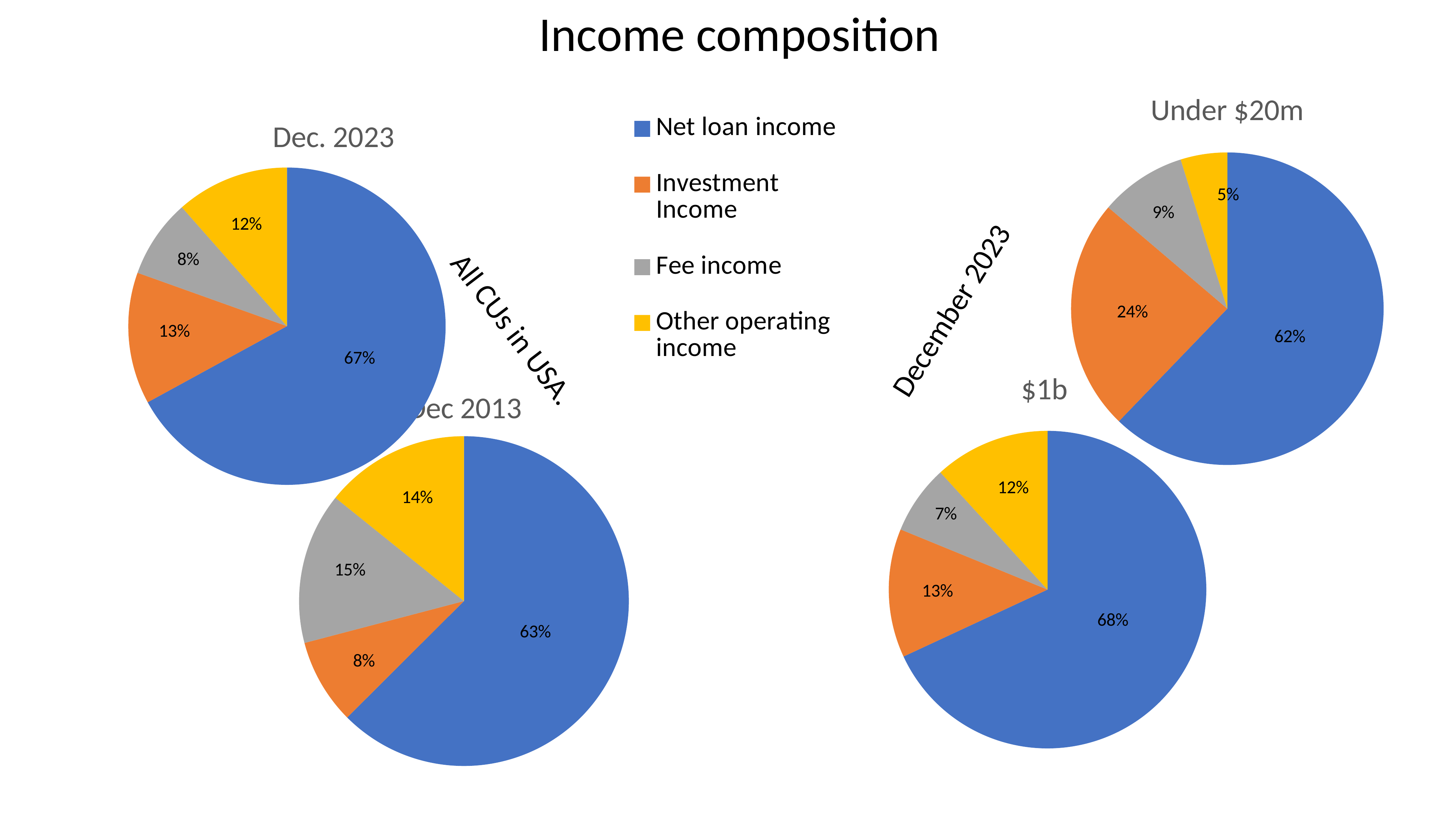
How many slices does the "$1b" pie chart have? 4 Which is larger: the Fee income share in the "Dec 2013" pie chart or in the "Dec. 2023" pie chart? Dec 2013 How many entries does the legend list? 4 In the "Dec. 2023" pie chart, what share is Net loan income? 67% In the "Under $20m" pie chart, what share is Investment Income? 24% What is the difference between the Net loan income share in the "$1b" pie chart and in the "Under $20m" pie chart? 6 percentage points In the "Dec 2013" pie chart, what share is Fee income? 15% In the "Under $20m" pie chart, which category has the smallest share? Other operating income In the "$1b" pie chart, what share is Other operating income? 12% What type of chart is used for "Dec. 2023"? Pie chart In the "Dec 2013" pie chart, which category has the largest share? Net loan income Which colour represents Investment Income in the legend? Orange